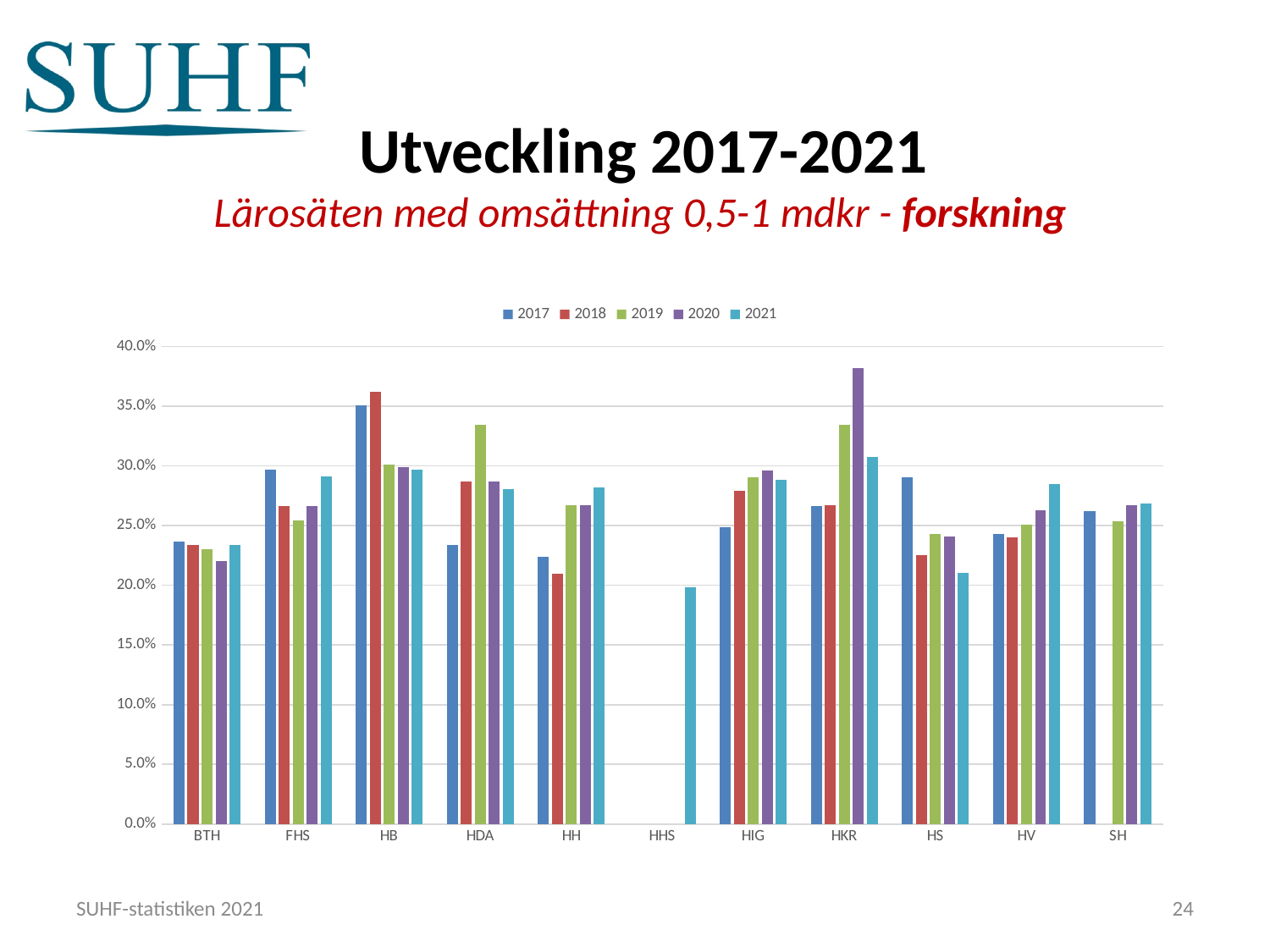
Is the value for HH in 2018 greater or less than 25.0%? less Is the value for HB in 2018 greater or less than 35.0%? greater Is the value for FHS in 2017 greater or less than 25.0%? greater What kind of chart is shown on the slide? bar chart How many series does the legend list? 5 Which is larger, the 2017 value for HB or the 2017 value for HDA? HB For HV, do the values rise or fall from 2018 to 2021? rise Which category has a bar for only one year? HHS Which category and year has the highest bar in the chart? HKR, 2020 Which is larger, the 2019 value for HKR or the 2019 value for HIG? HKR How many categories are shown on the x axis? 11